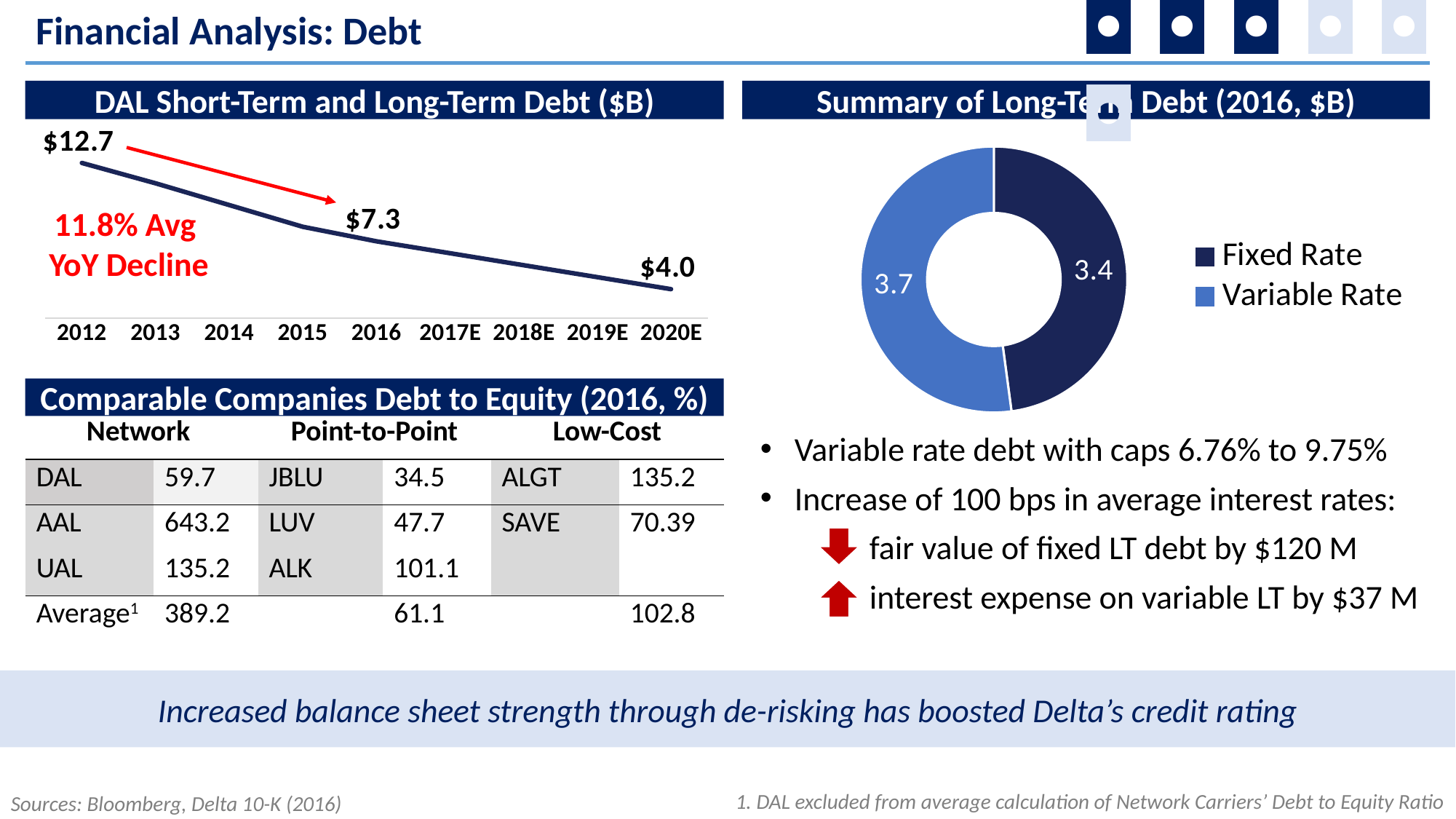
In the DAL Short-Term and Long-Term Debt chart, what is the debt value shown for 2012? $12.7 In the DAL Short-Term and Long-Term Debt chart, what is the difference between the 2012 value and the 2016 value? $5.4 In the Summary of Long-Term Debt chart, what is the value for Variable Rate? 3.7 In the DAL Short-Term and Long-Term Debt chart, what is the difference between the 2012 value and the 2020E value? $8.7 In the Summary of Long-Term Debt chart, what is the value for Fixed Rate? 3.4 What kind of chart is the DAL Short-Term and Long-Term Debt chart? line chart In the DAL Short-Term and Long-Term Debt chart, what is the debt value shown for 2020E? $4.0 In the DAL Short-Term and Long-Term Debt chart, what is the debt value shown for 2016? $7.3 In the Summary of Long-Term Debt chart, which category is larger, Fixed Rate or Variable Rate? Variable Rate How many entries does the legend of the Summary of Long-Term Debt chart list? 2 How many years are shown on the x axis of the DAL Short-Term and Long-Term Debt chart? 9 In the DAL Short-Term and Long-Term Debt chart, do the values rise or fall from 2012 to 2020E? fall